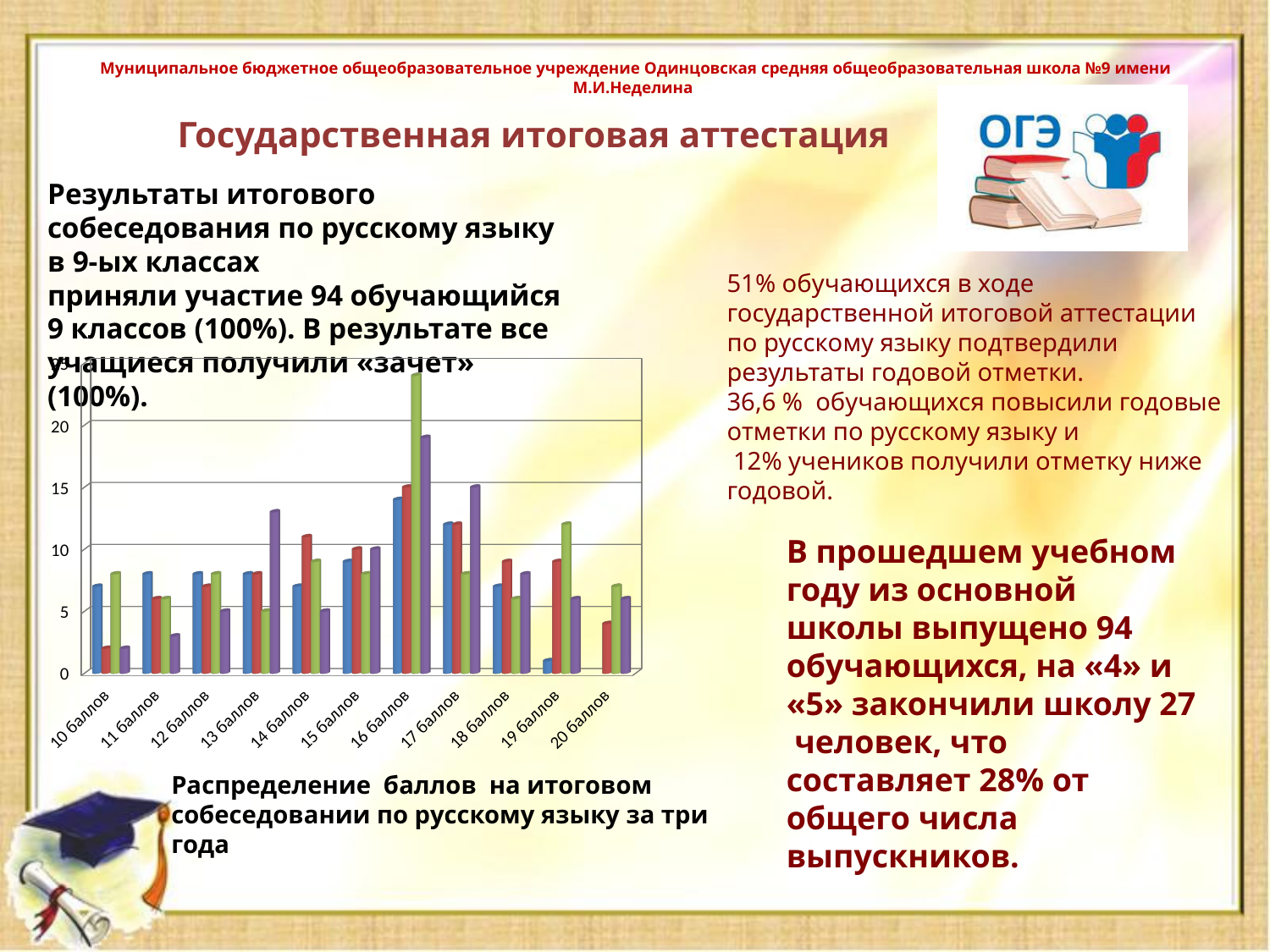
What kind of chart is shown on the slide? bar chart Is the green bar for 16 баллов greater or less than 20? greater Which score category contains the tallest bar in the chart? 16 баллов Is the purple bar for 16 баллов greater or less than 15? greater For 10 баллов, which is larger: the blue bar or the red bar? blue bar For 13 баллов, which colour bar is the tallest? purple What caption is given below the chart? Распределение баллов на итоговом собеседовании по русскому языку за три года For 16 баллов, which is larger: the green bar or the blue bar? green bar Is the blue bar for 19 баллов greater or less than 5? less How many score categories are shown along the x axis of the chart? 11 How many bars are plotted for each score category in the chart? 4